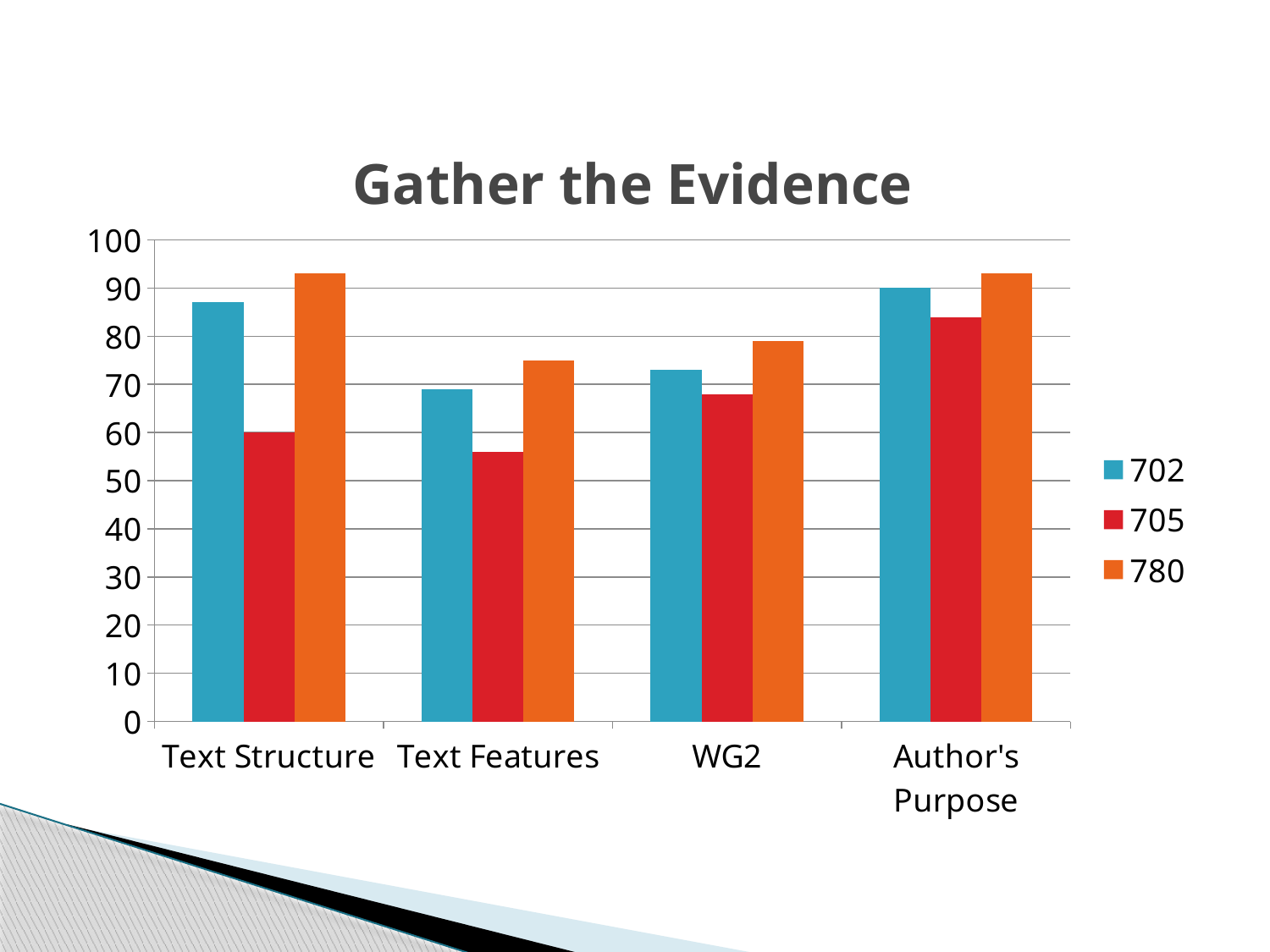
Is the value for series 780 in the Text Structure category greater or less than 90? greater Which series has the highest value in the WG2 category? 780 What is the title of the chart? Gather the Evidence How many categories are shown on the x axis? 4 What is the value for series 702 in the Author's Purpose category? 90 Is the value for series 705 in the Text Features category greater or less than 60? less How many series does the legend list? 3 Is the value for series 702 in the WG2 category greater or less than 70? greater Which category has the lowest value for series 705? Text Features What kind of chart is shown on the slide? bar chart In the Text Features category, which is larger: the value for series 702 or the value for series 705? 702 What is the value for series 705 in the Text Structure category? 60